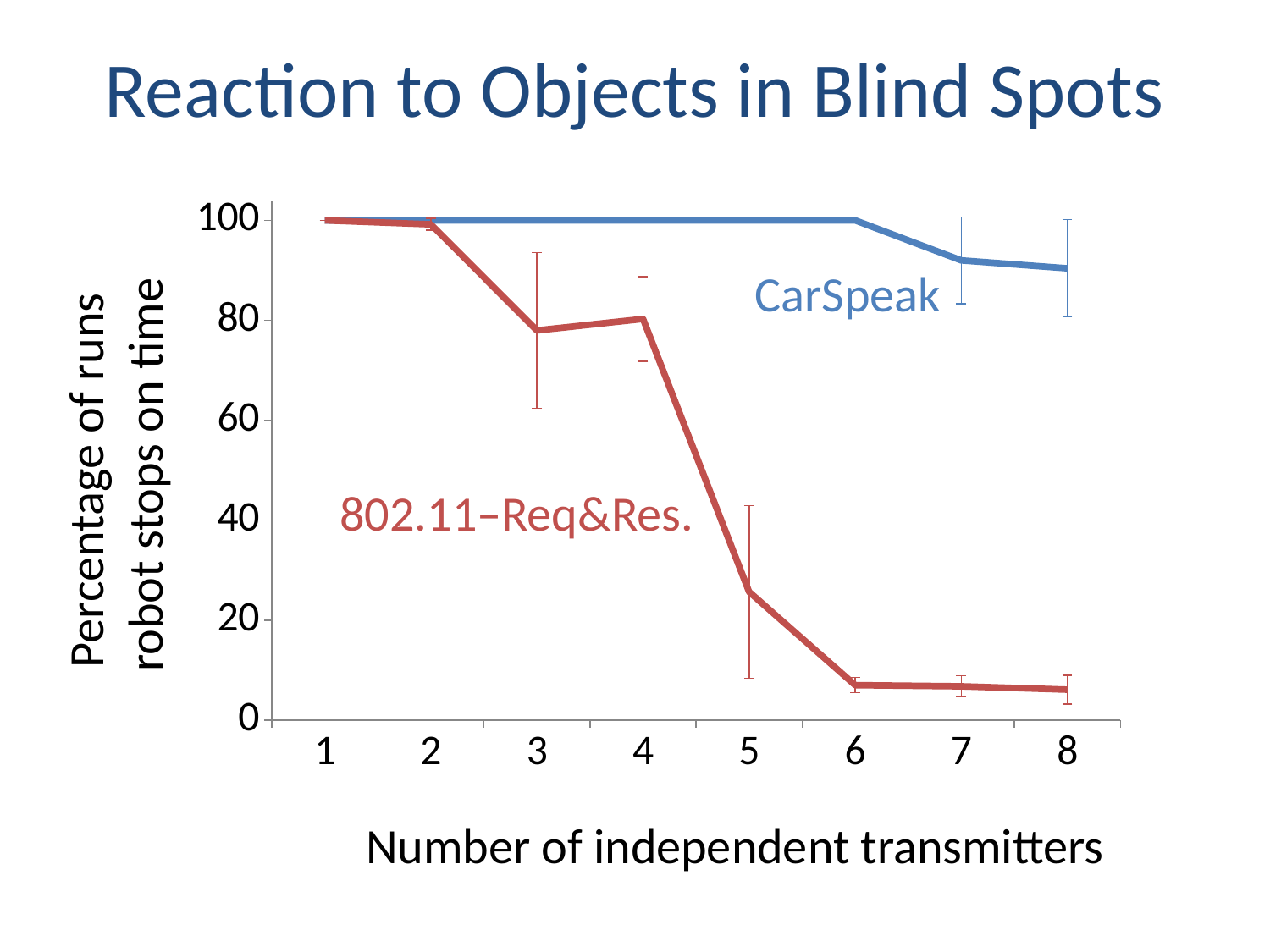
What is the label of the x axis? Number of independent transmitters Is the value for 802.11–Req&Res. at 3 independent transmitters greater or less than 60? greater Which series has the higher value at 5 independent transmitters, CarSpeak or 802.11–Req&Res.? CarSpeak What is the value for CarSpeak at 1 independent transmitter? 100 How many points along the x axis (number of independent transmitters) are plotted for each series? 8 Is the value for 802.11–Req&Res. at 6 independent transmitters greater or less than 20? less Is the value for 802.11–Req&Res. at 5 independent transmitters greater or less than 40? less Does the value for 802.11–Req&Res. rise or fall as the number of independent transmitters increases from 1 to 8? fall What is the value for 802.11–Req&Res. at 1 independent transmitter? 100 What kind of chart is shown on the slide? line chart How many series are plotted on the chart? 2